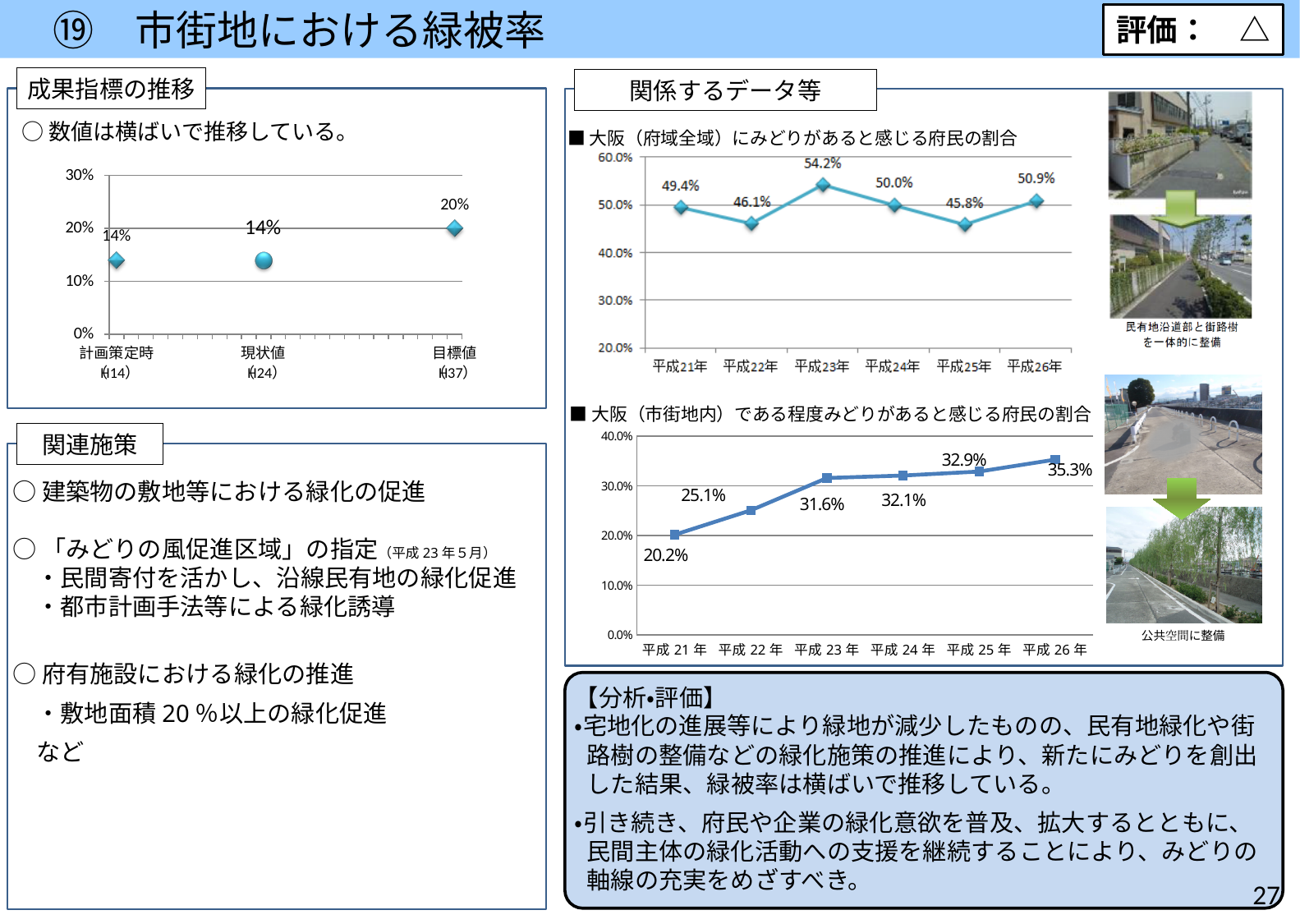
In the chart titled 大阪（市街地内）である程度みどりがあると感じる府民の割合, which year has the highest value? 平成26年 In the chart titled 大阪（市街地内）である程度みどりがあると感じる府民の割合, what is the value for 平成21年? 20.2% In the chart titled 大阪（市街地内）である程度みどりがあると感じる府民の割合, what kind of chart is shown? line chart In the 成果指標の推移 chart on the left of the slide, is the value for 目標値 larger or smaller than the value for 計画策定時? larger In the chart titled 大阪（市街地内）である程度みどりがあると感じる府民の割合, what is the difference between the values for 平成26年 and 平成21年? 15.1% In the chart titled 大阪（府域全域）にみどりがあると感じる府民の割合, how many data points are plotted? 6 In the chart titled 大阪（府域全域）にみどりがあると感じる府民の割合, what is the value for 平成23年? 54.2% In the chart titled 大阪（府域全域）にみどりがあると感じる府民の割合, what is the difference between the values for 平成23年 and 平成22年? 8.1% In the 成果指標の推移 chart on the left of the slide, what is the value for 現状値 (H24)? 14% In the 成果指標の推移 chart on the left of the slide, what is the value for 目標値 (H37)? 20% In the chart titled 大阪（市街地内）である程度みどりがあると感じる府民の割合, do the values rise or fall from 平成21年 to 平成26年? rise In the chart titled 大阪（府域全域）にみどりがあると感じる府民の割合, which year has the lowest value? 平成25年